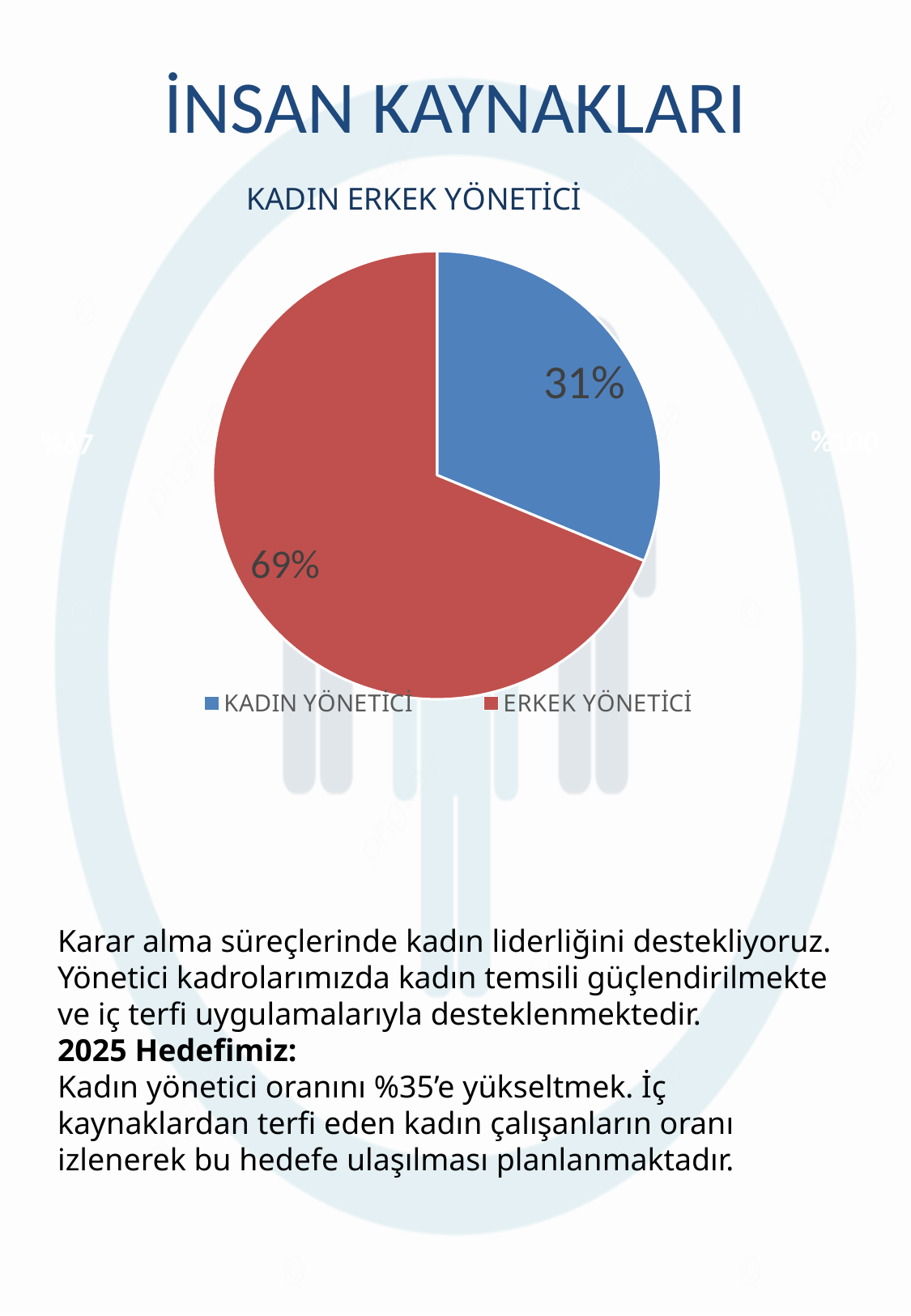
Which category has the largest share of the pie? ERKEK YÖNETİCİ What type of chart is shown on the slide? pie chart What percentage of the pie is ERKEK YÖNETİCİ? 69% Which category has the smallest share of the pie? KADIN YÖNETİCİ What percentage of the pie is KADIN YÖNETİCİ? 31% What is the title of the pie chart? KADIN ERKEK YÖNETİCİ What is the share of the pie for ERKEK YÖNETİCİ? 69% How many slices does the pie chart have? 2 What colour is the KADIN YÖNETİCİ slice? blue What is the difference in percentage points between ERKEK YÖNETİCİ and KADIN YÖNETİCİ? 38 How many entries does the legend list? 2 Which is larger, the share for KADIN YÖNETİCİ or ERKEK YÖNETİCİ? ERKEK YÖNETİCİ